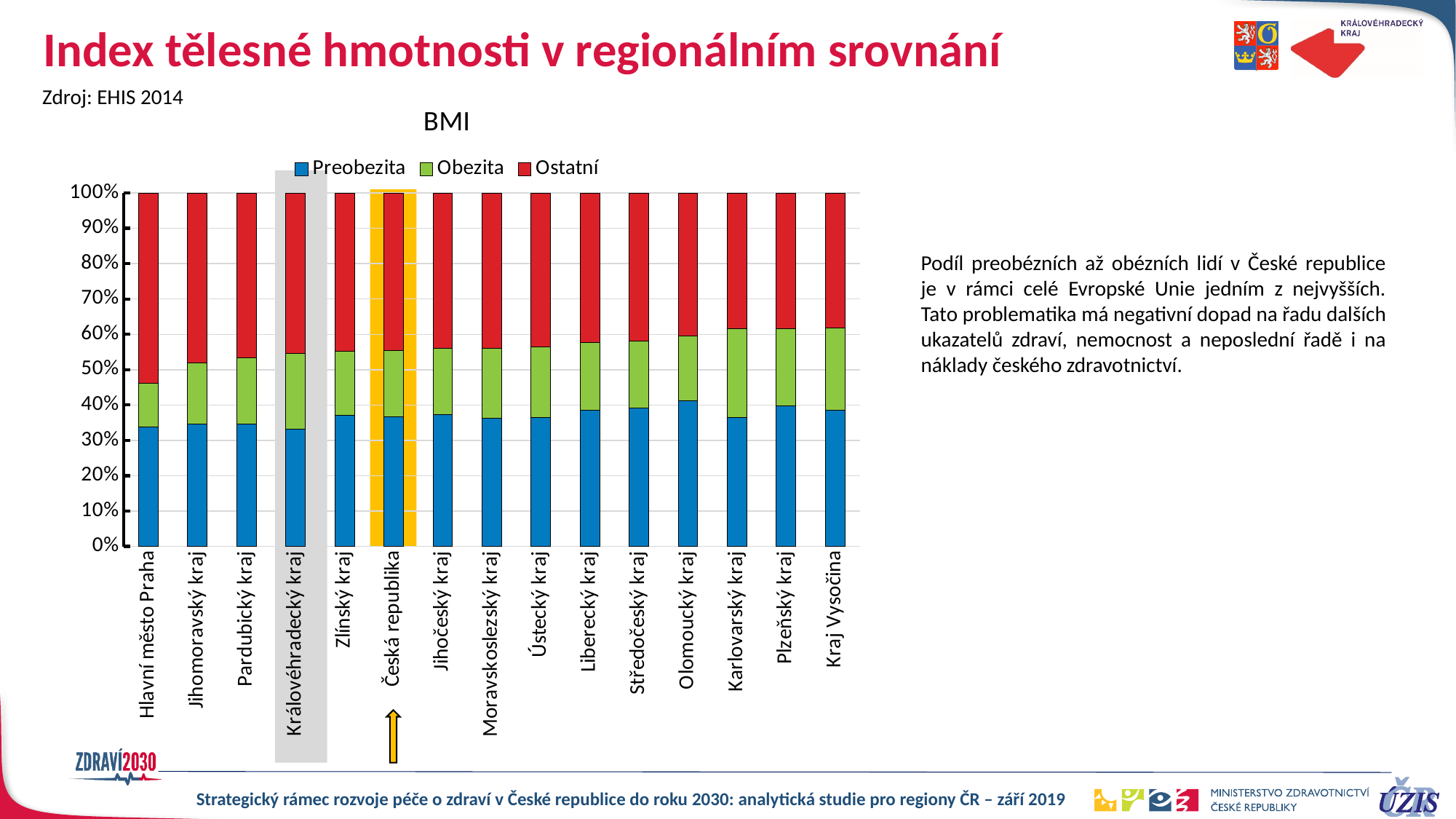
What kind of chart is shown on the slide? Stacked bar chart Does the Ostatní share rise or fall moving from left to right along the x axis? fall Is the Preobezita value for Hlavní město Praha greater or less than 40%? less Which legend entry is shown in red in the BMI chart? Ostatní Is the Ostatní share for Hlavní město Praha greater or less than 50%? greater Is the Obezita share for Hlavní město Praha greater or less than 10%? greater What is the total of each stacked bar in the BMI chart? 100% How many series does the legend of the BMI chart list? 3 Which has the larger Ostatní share: Hlavní město Praha or Kraj Vysočina? Hlavní město Praha Which category has the largest Ostatní share in the BMI chart? Hlavní město Praha How many categories (regions) are shown on the x axis of the BMI chart? 15